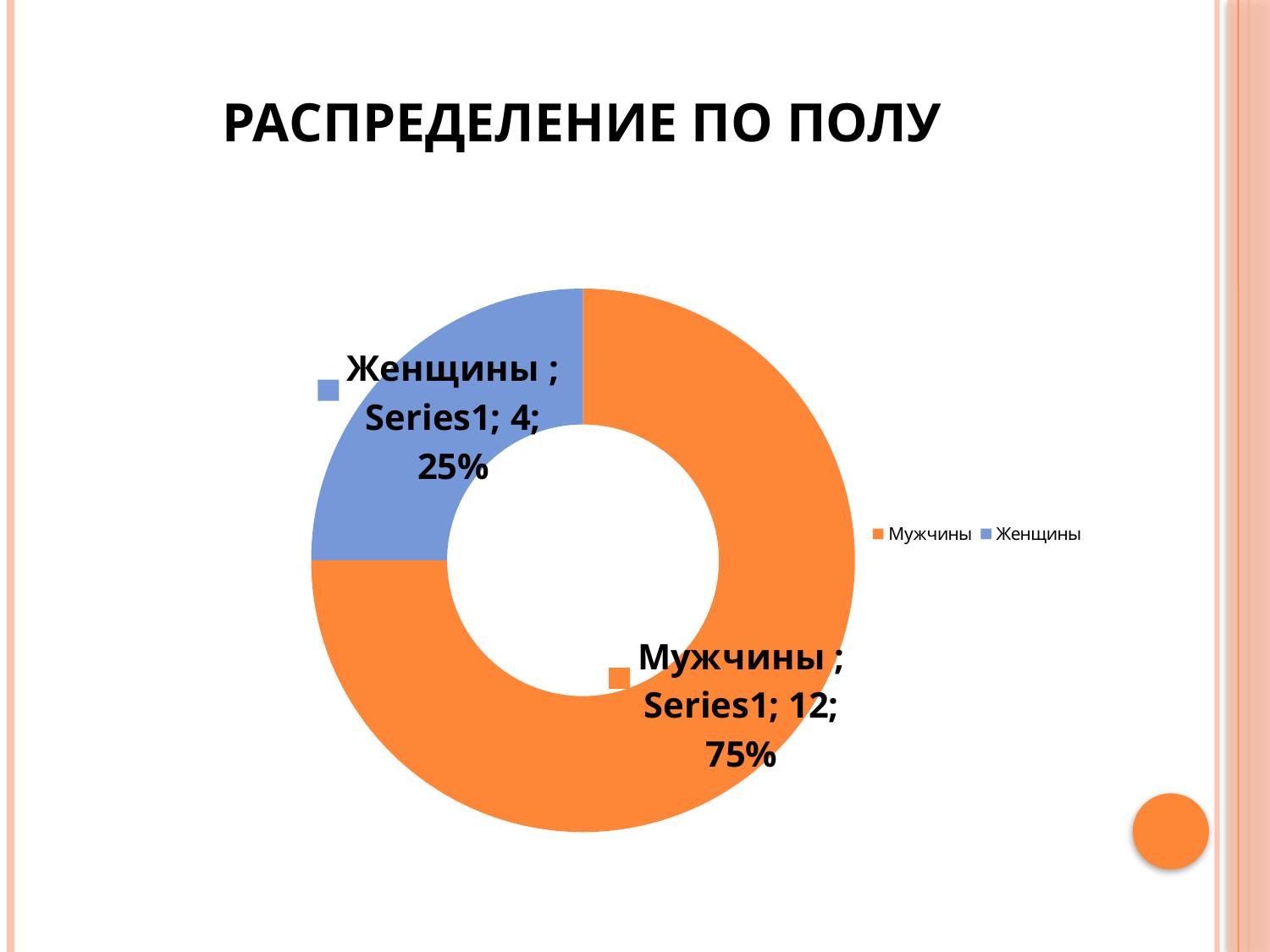
Which category has the largest slice? Мужчины Which is larger, the value for Мужчины or the value for Женщины? Мужчины Which category has the smallest slice? Женщины What is the value for Женщины? 4 What share of the chart does the Мужчины slice represent? 75% What is the title of the slide? РАСПРЕДЕЛЕНИЕ ПО ПОЛУ What share of the chart does the Женщины slice represent? 25% What is the value for Мужчины? 12 What kind of chart is shown on the slide? Doughnut (pie) chart How many categories does the chart show? 2 What is the difference between the values for Мужчины and Женщины? 8 What is the total of the two values shown in the chart? 16